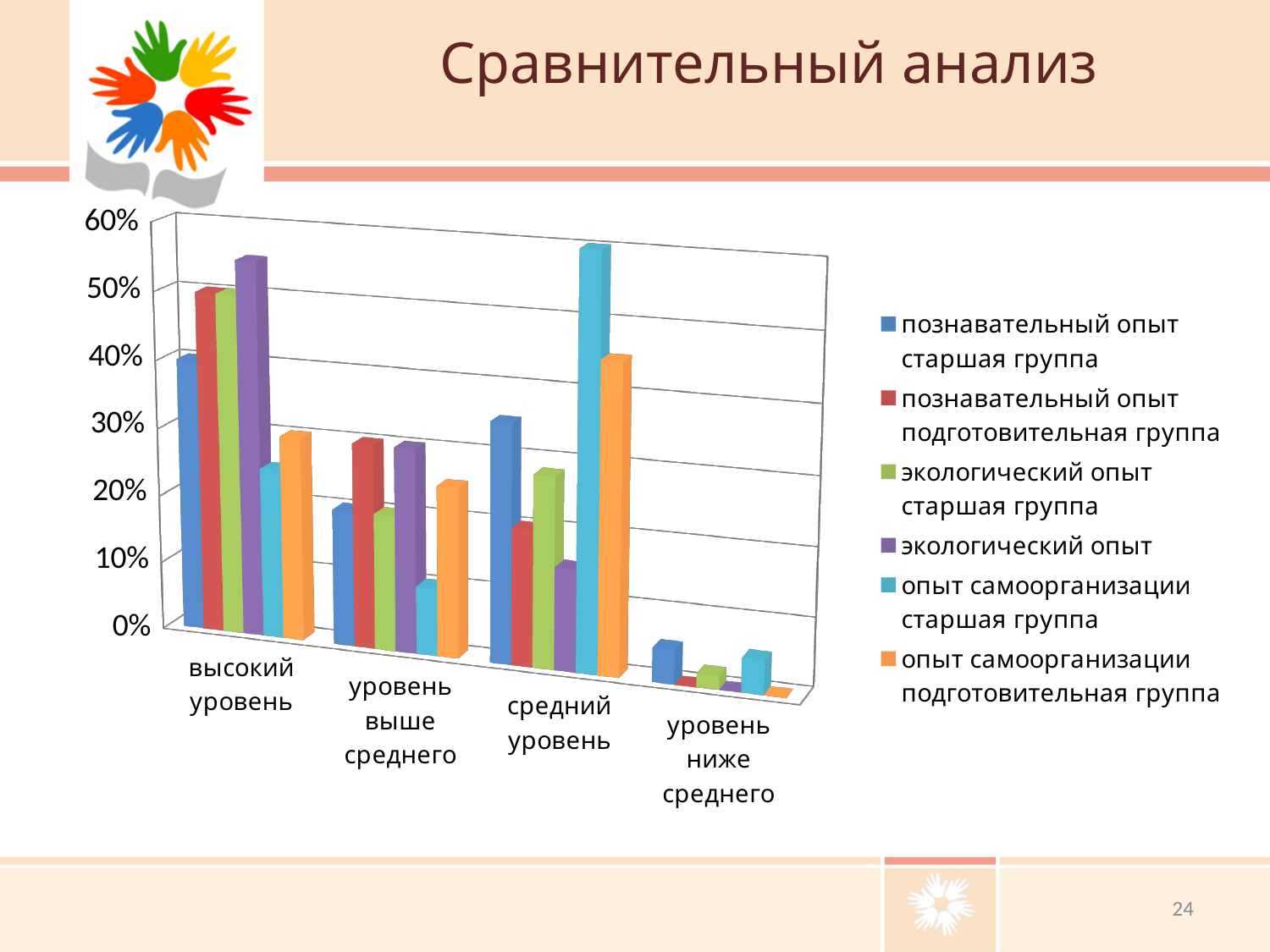
Is the value for "познавательный опыт старшая группа" in the "высокий уровень" category greater or less than 30%? greater Is the value for "опыт самоорганизации старшая группа" in the "средний уровень" category greater or less than 50%? greater What is the title of the slide? Сравнительный анализ How many series does the legend list? 6 For which category is the value of "познавательный опыт старшая группа" the lowest? уровень ниже среднего Which series has the highest value in the "высокий уровень" category? экологический опыт Is the value for "опыт самоорганизации старшая группа" in the "уровень выше среднего" category greater or less than 20%? less How many categories are shown on the x axis of the chart? 4 For which category is the value of "опыт самоорганизации старшая группа" the highest? средний уровень In the "средний уровень" category, which is larger: "опыт самоорганизации старшая группа" or "экологический опыт"? опыт самоорганизации старшая группа Which series is shown in orange in the legend? опыт самоорганизации подготовительная группа What kind of chart is shown on the slide? bar chart